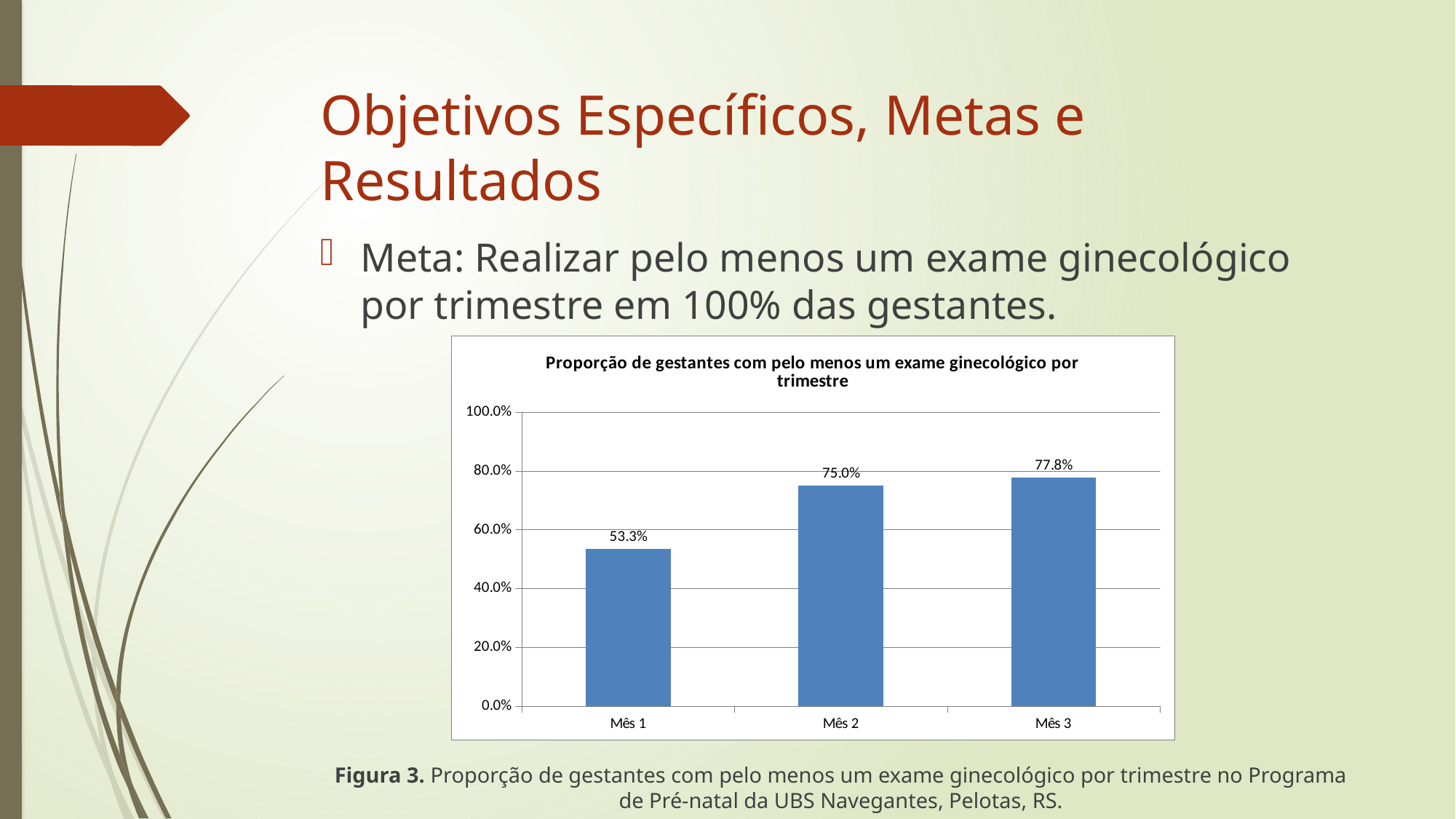
What is the value for Mês 1? 53.3% Which is larger, the value for Mês 1 or the value for Mês 2? Mês 2 What is the value for Mês 3? 77.8% What is the value for Mês 2? 75.0% Is the value for Mês 1 greater or less than 60.0%? less What kind of chart is shown? bar chart Which month has the lowest value? Mês 1 Do the values rise or fall from Mês 1 to Mês 3? rise How many months are shown on the x axis? 3 Which month has the highest value? Mês 3 What is the difference between the values for Mês 3 and Mês 2? 2.8% What is the difference between the values for Mês 2 and Mês 1? 21.7%